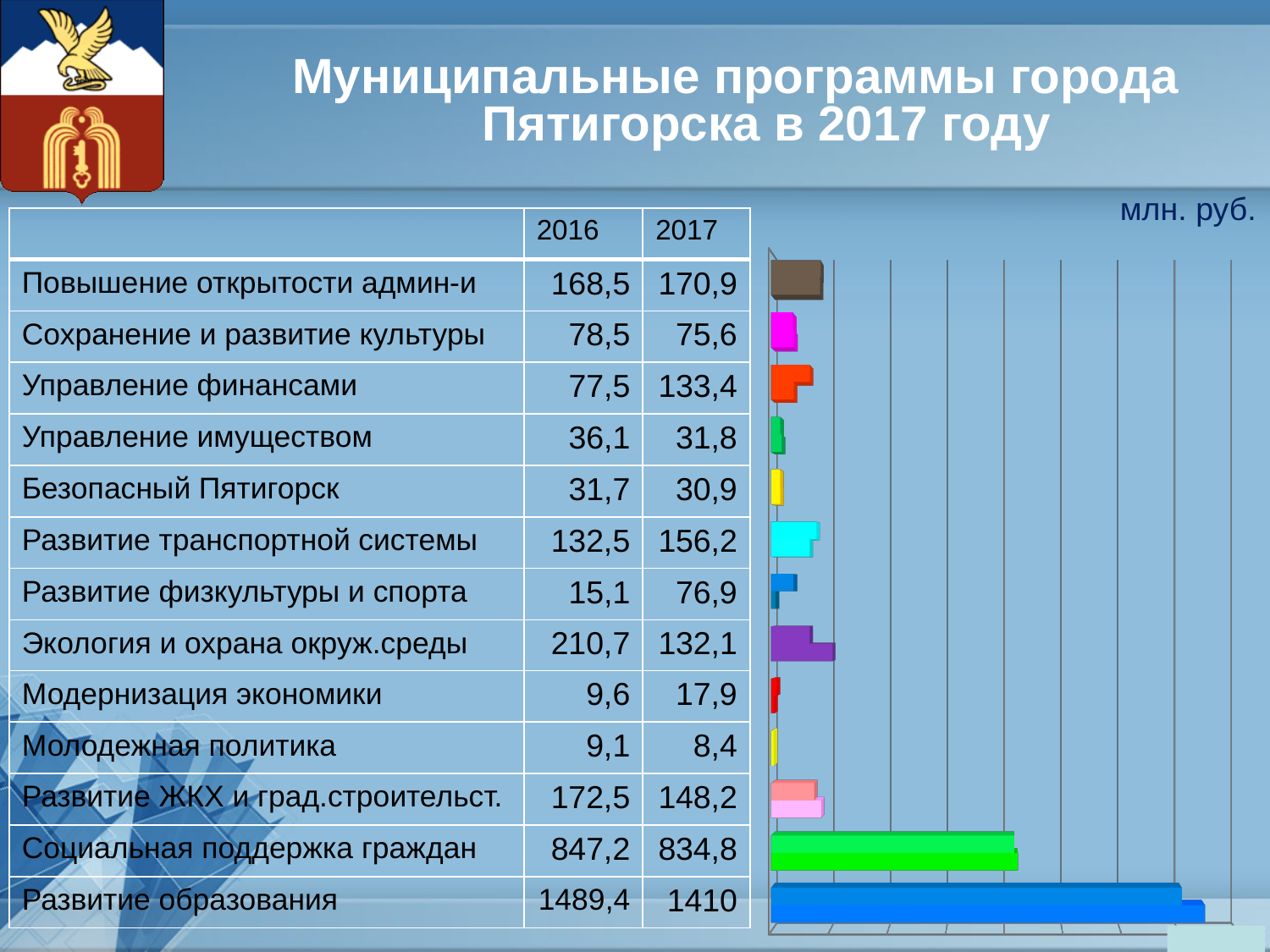
What kind of chart is shown on the slide? Bar chart How many municipal programmes (categories) are listed in the table and chart? 13 What is the value for Управление финансами in 2016? 77,5 Which programme has the lowest value in 2017? Молодежная политика For Экология и охрана окруж.среды, which year has the larger value, 2016 or 2017? 2016 Which programme has the highest value in 2017? Развитие образования What is the difference between the 2016 and 2017 values for Развитие образования? 79,4 In what units are the values on the slide expressed? млн. руб. How many years (data series) are shown for each programme? 2 What is the difference between the 2017 and 2016 values for Управление финансами? 55,9 What is the value for Развитие образования in 2017? 1410 What is the value for Социальная поддержка граждан in 2017? 834,8